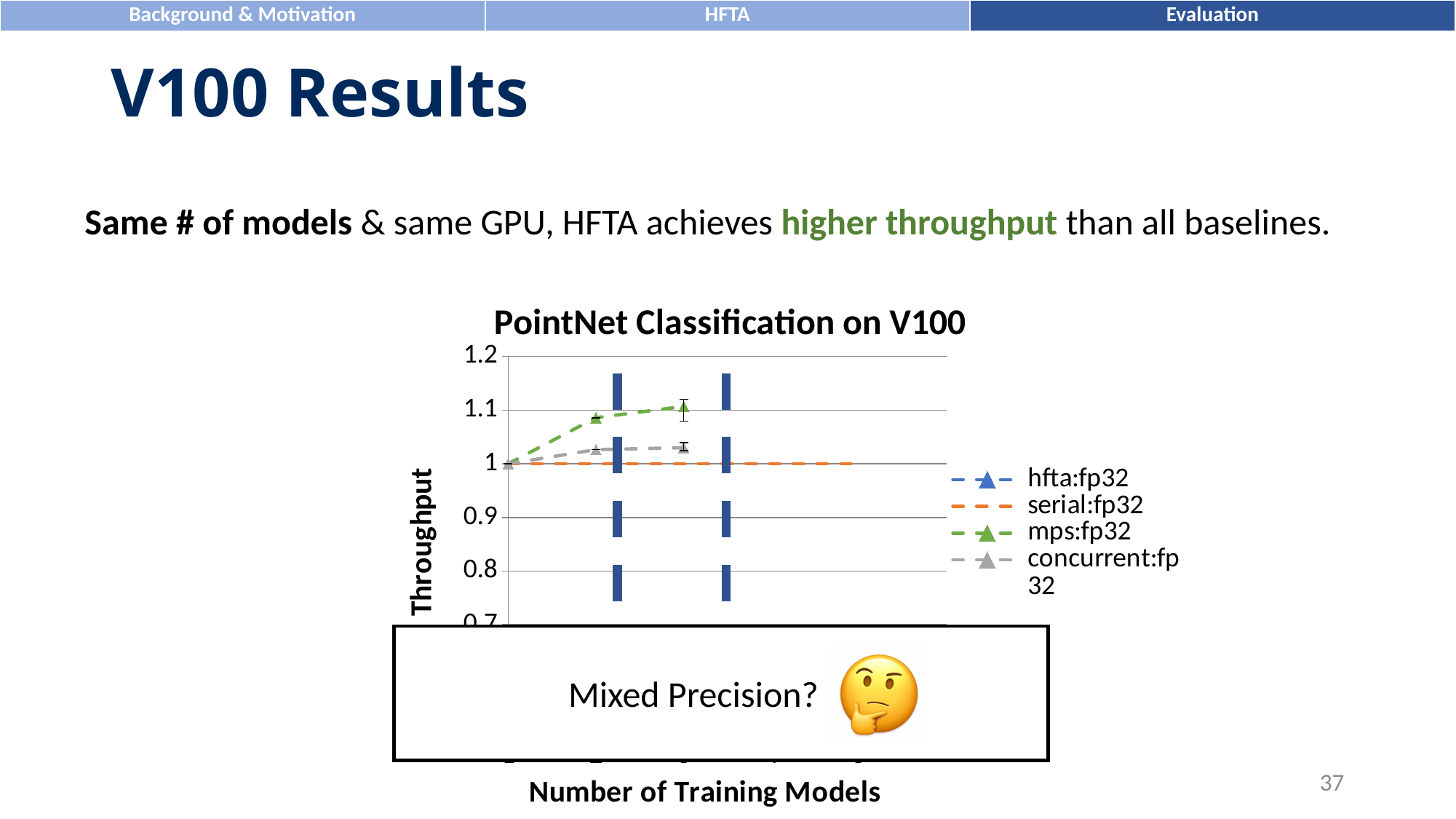
Does the mps:fp32 series rise or fall as the number of training models increases? rise Is the serial:fp32 series greater or less than 1.1 throughout the chart? less What is the title of the chart? PointNet Classification on V100 Is the rightmost plotted value for concurrent:fp32 greater or less than 1.1? less At the rightmost plotted point, which series has the higher throughput, mps:fp32 or concurrent:fp32? mps:fp32 Is the rightmost plotted value for mps:fp32 greater or less than 1? greater How many series does the chart's legend list? 4 What kind of chart is shown on the slide? line chart Which series is plotted with the lowest throughput at the rightmost plotted point, serial:fp32 or mps:fp32? serial:fp32 Does the serial:fp32 series rise, fall, or stay flat across the x axis? stay flat What is the label of the chart's y axis? Throughput